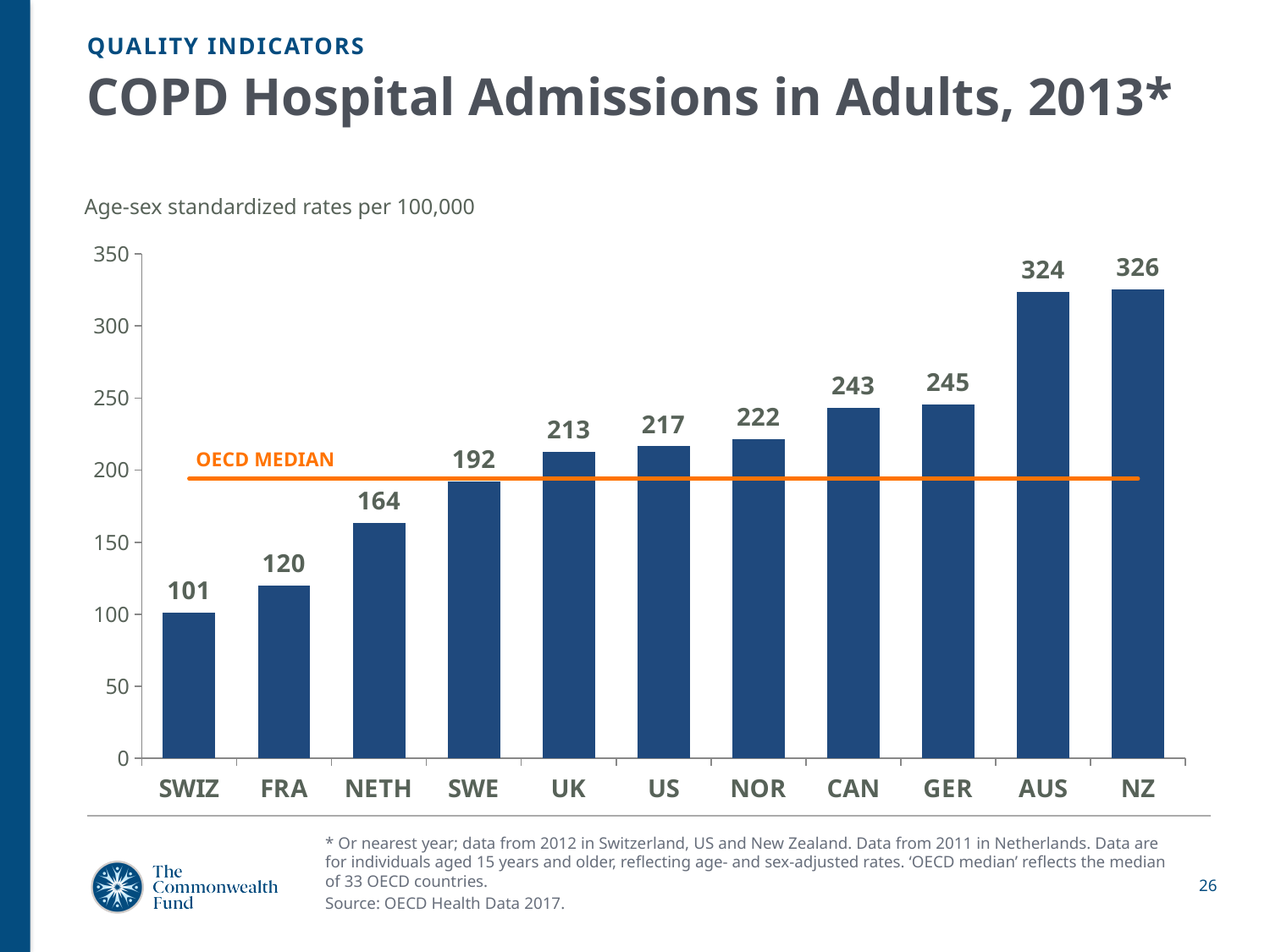
What is the COPD hospital admission rate for the UK? 213 What is the value shown for NETH? 164 What kind of chart is shown on the slide? Bar chart Do the values rise or fall from left to right across the countries? Rise How many countries are shown in the chart? 11 Which country has the lowest COPD hospital admission rate? SWIZ What is the difference between the values for AUS and CAN? 81 Is the value for SWE greater or less than 200? less What does the orange horizontal line on the chart represent? OECD median Which has a higher value, GER or NOR? GER Which country has the highest COPD hospital admission rate? NZ What unit is used for the rates in the chart? Age-sex standardized rates per 100,000